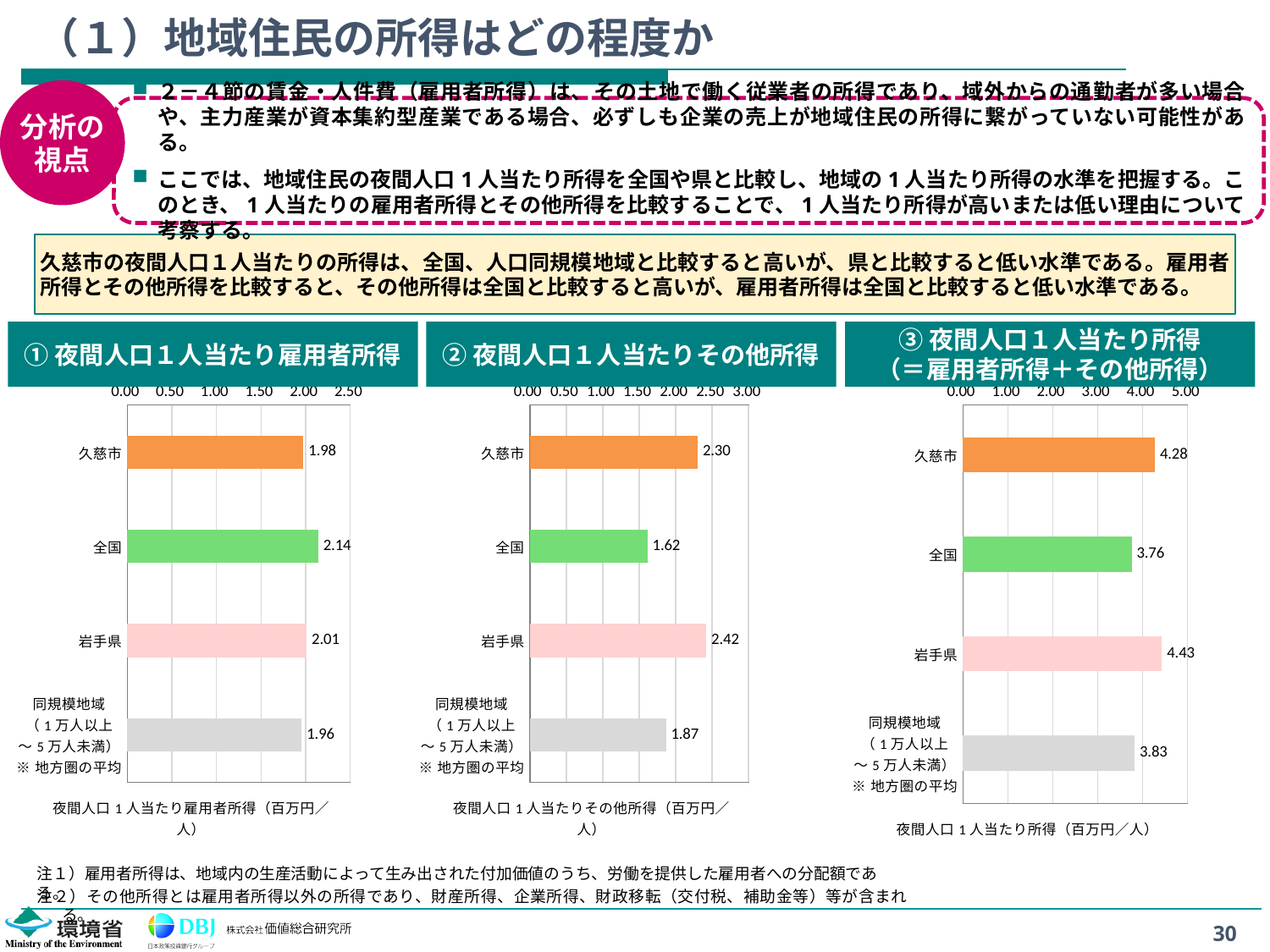
In the chart ② 夜間人口１人当たりその他所得, which category has the highest value? 岩手県 In the chart ① 夜間人口１人当たり雇用者所得, which category has the lowest value? 同規模地域（１万人以上～５万人未満） In the chart ③ 夜間人口１人当たり所得, which category has the lowest value? 全国 What type of chart is the chart ② 夜間人口１人当たりその他所得? Bar chart In the chart ③ 夜間人口１人当たり所得, which is larger, 久慈市 or 全国? 久慈市 In the chart ③ 夜間人口１人当たり所得, what is the difference between 岩手県 and 久慈市? 0.15 In the chart ② 夜間人口１人当たりその他所得, what is the difference between 久慈市 and 全国? 0.68 In the chart ① 夜間人口１人当たり雇用者所得, what is the value for 久慈市? 1.98 In the chart ③ 夜間人口１人当たり所得, what is the value for 岩手県? 4.43 How many categories are shown in the chart ① 夜間人口１人当たり雇用者所得? 4 In the chart ② 夜間人口１人当たりその他所得, what is the value for 全国? 1.62 In the chart ① 夜間人口１人当たり雇用者所得, which category has the highest value? 全国